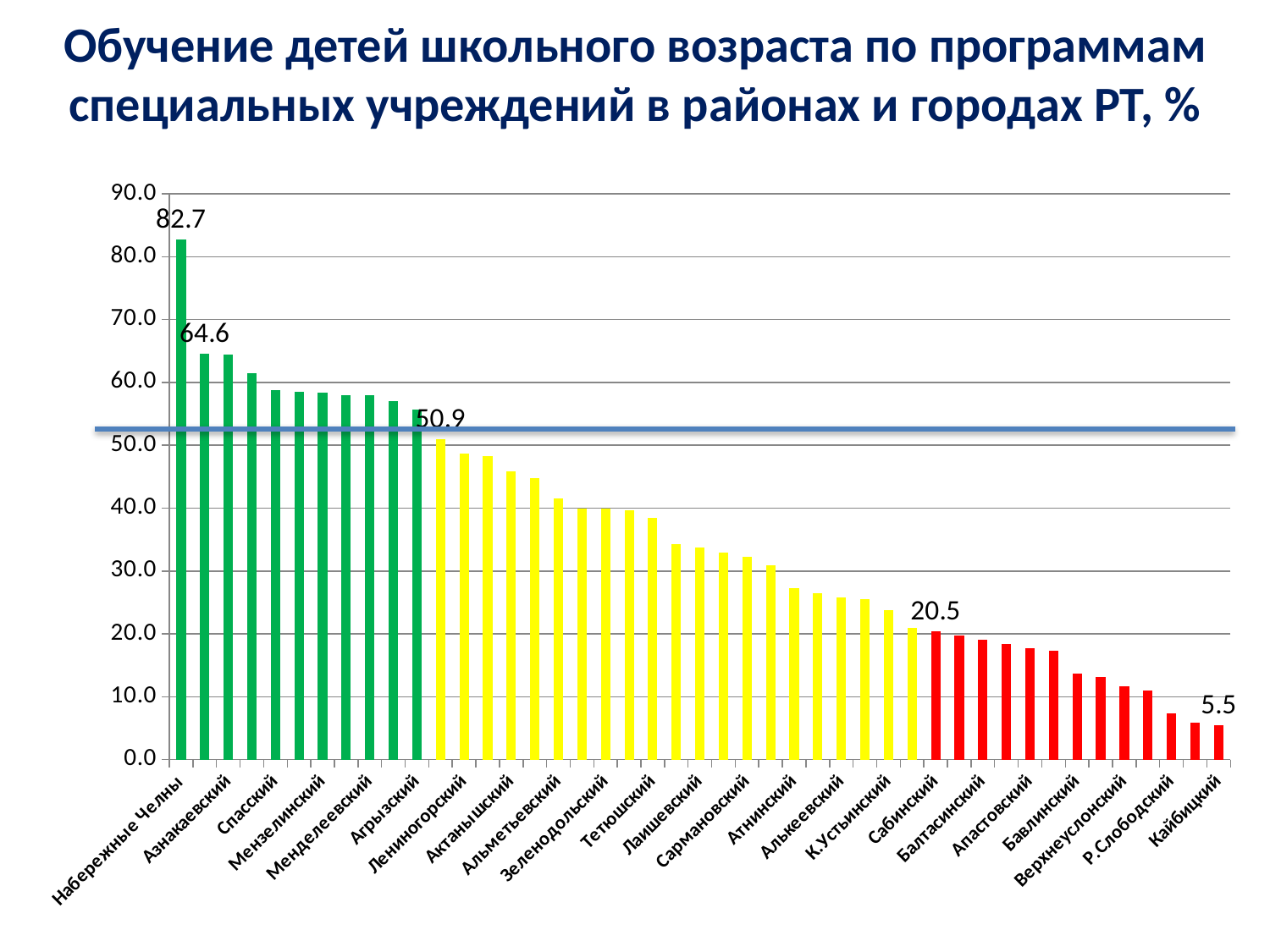
What kind of chart is shown on the slide? bar chart Which category has the lowest value? Кайбицкий What is the value for Сабинский? 20.5 Which category has the highest value? Набережные Челны Which is larger, the value for Сабинский or the value for Кайбицкий? Сабинский Do the values rise or fall from left to right along the x axis? fall What is the value for Кайбицкий? 5.5 What is the difference between the values for Набережные Челны and Кайбицкий? 77.2 Is the value for Азнакаевский greater or less than 60? greater Is the value for Атнинский greater or less than 30? less What is the value for Набережные Челны? 82.7